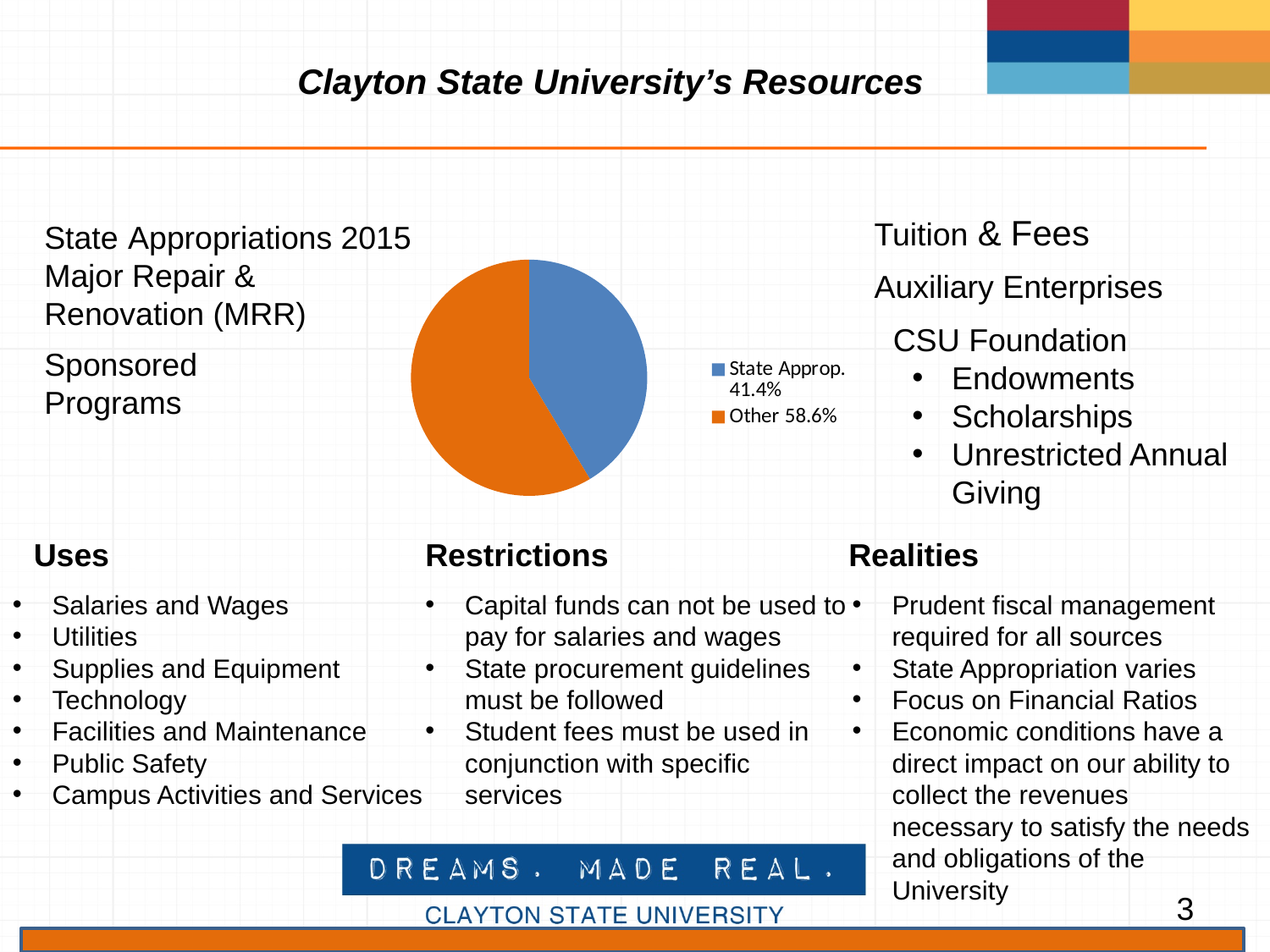
What colour is the State Approp. slice in the pie chart? blue What is the difference in percentage points between the Other slice and the State Approp. slice? 17.2 Is the share for State Approp. greater or less than 50%? less Which is larger in the pie chart, State Approp. or Other? Other How many entries does the pie chart's legend list? 2 Which slice of the pie chart is the smallest? State Approp. What colour is the Other slice in the pie chart? orange How many slices does the pie chart have? 2 What share of the pie is labelled Other? 58.6% What share of the pie is labelled State Approp.? 41.4% What kind of chart is shown on the slide? pie chart Which slice of the pie chart is the largest? Other